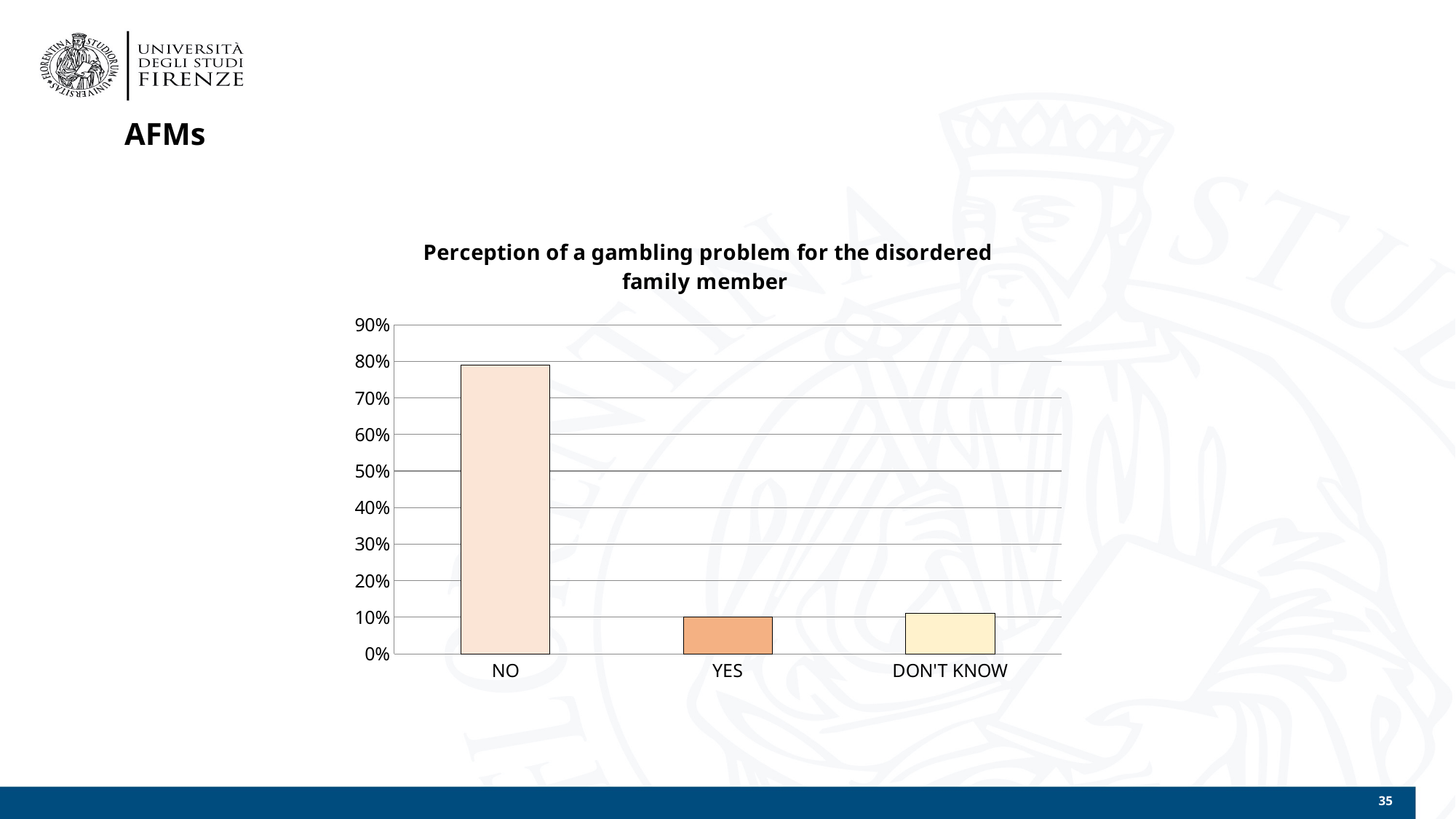
What is the value for YES in the chart? 10% Which is larger, the value for NO or the value for DON'T KNOW? NO Is the value for DON'T KNOW greater or less than 20%? less Which category has the highest value in the chart? NO What is the highest value shown on the y axis of the chart? 90% Is the value for NO greater or less than 50%? greater What is the title of the chart? Perception of a gambling problem for the disordered family member Which is larger, the value for NO or the value for YES? NO Is the value for NO greater or less than 70%? greater How many categories are shown on the x axis of the chart? 3 What kind of chart is shown on the slide? bar chart